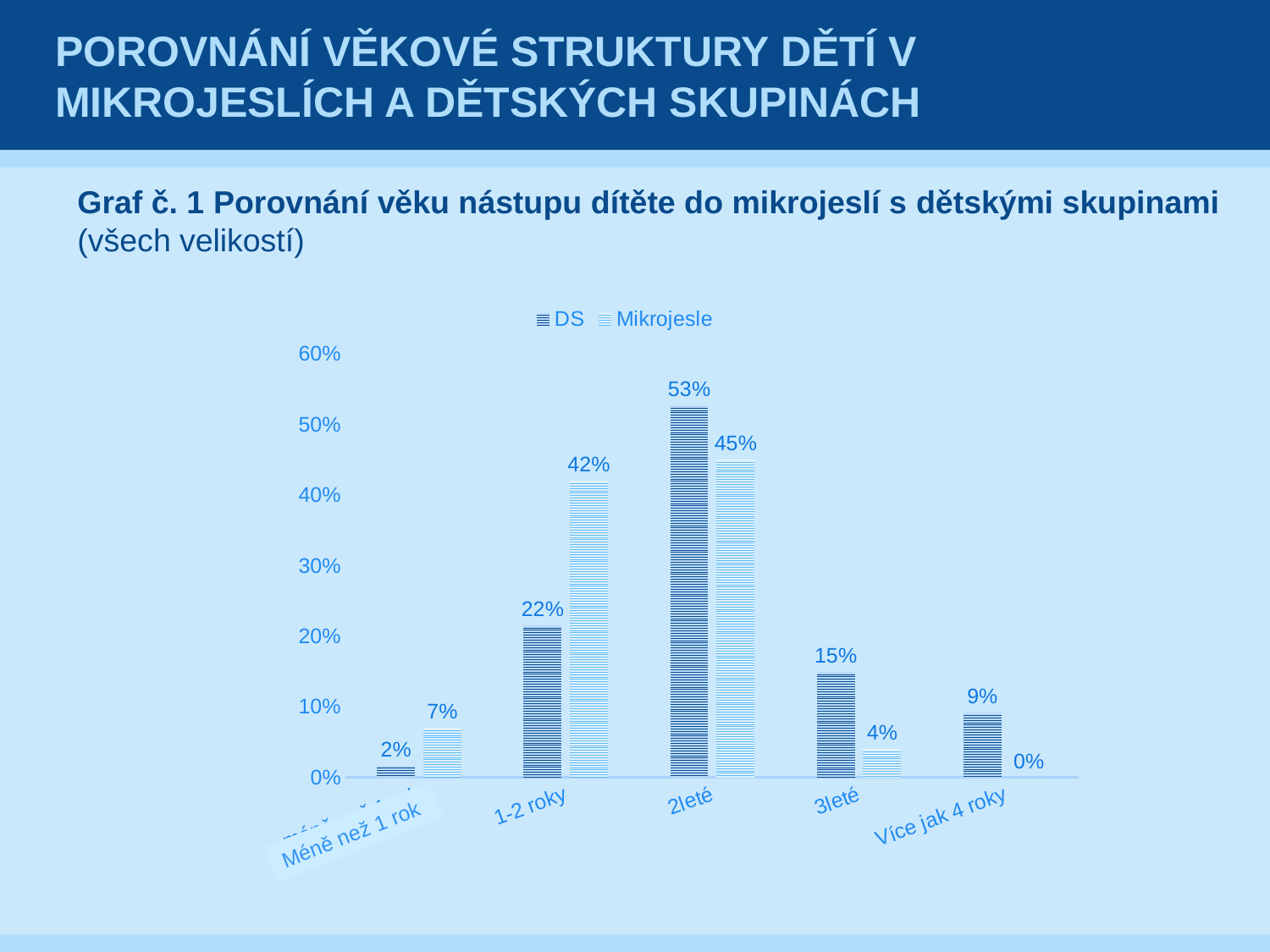
What is the value for DS in the 3leté category? 15% Which is larger in the Méně než 1 rok category, DS or Mikrojesle? Mikrojesle How many categories are shown on the x axis? 5 Which category has the lowest value for the Mikrojesle series? Více jak 4 roky How many series does the legend list? 2 What kind of chart is shown on the slide? Bar chart Which category has the highest value for the DS series? 2leté What are the two series named in the legend? DS and Mikrojesle What is the difference between DS and Mikrojesle in the 1-2 roky category? 20% What is the value for Mikrojesle in the Více jak 4 roky category? 0% What is the value for Mikrojesle in the 1-2 roky category? 42% What is the value for DS in the 2leté category? 53%